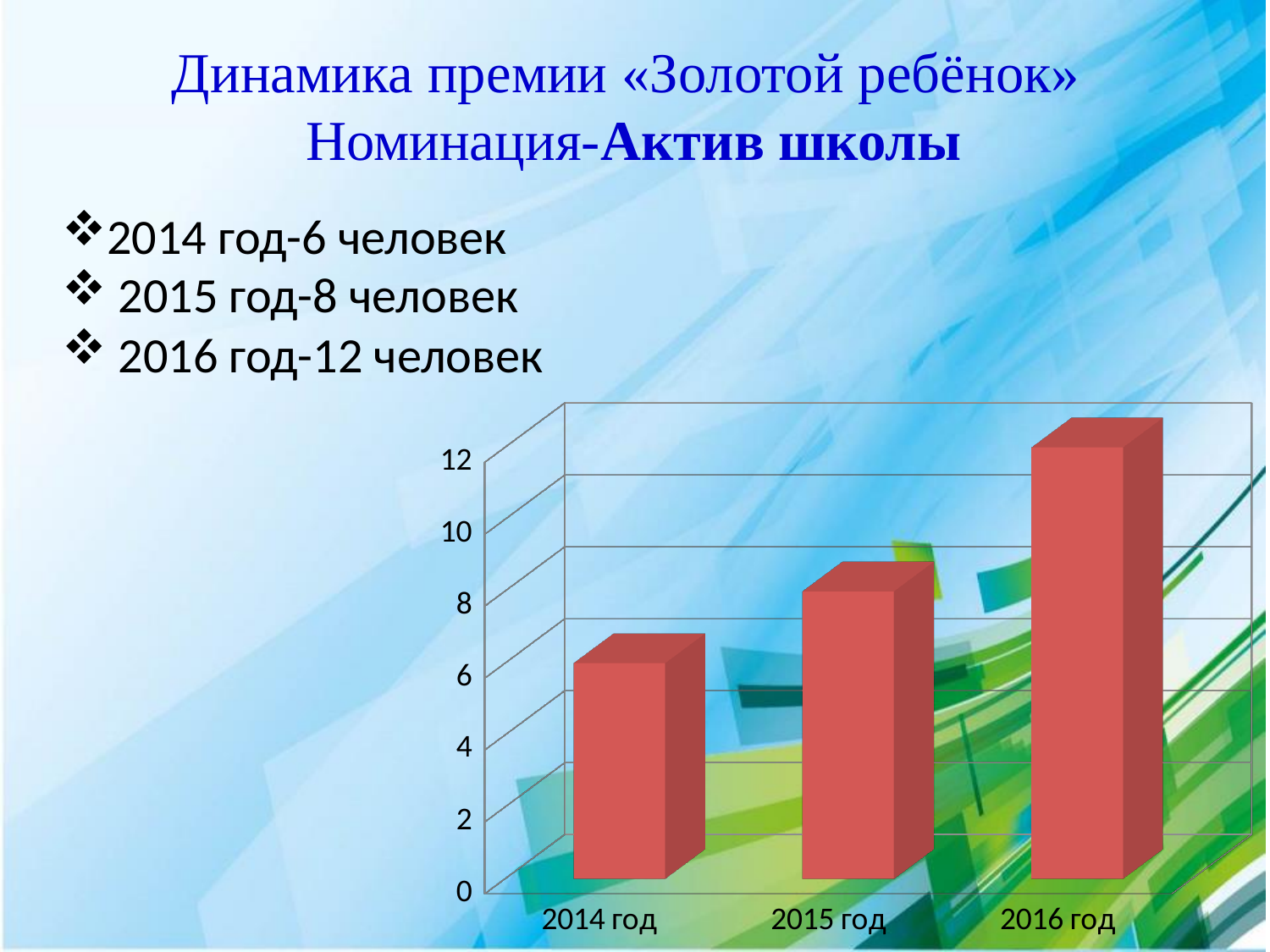
What is the difference between the values for 2016 год and 2014 год? 6 Do the values rise or fall from 2014 год to 2016 год? rise What is the value for 2016 год? 12 How many bars (categories) does the chart show? 3 What is the value for 2015 год? 8 What kind of chart is shown on the slide? bar chart Is the value for 2015 год greater or less than 10? less What is the difference between the values for 2015 год and 2014 год? 2 What is the value for 2014 год? 6 Which is larger, the value for 2015 год or the value for 2016 год? 2016 год Which year has the lowest bar? 2014 год Which year has the highest bar? 2016 год